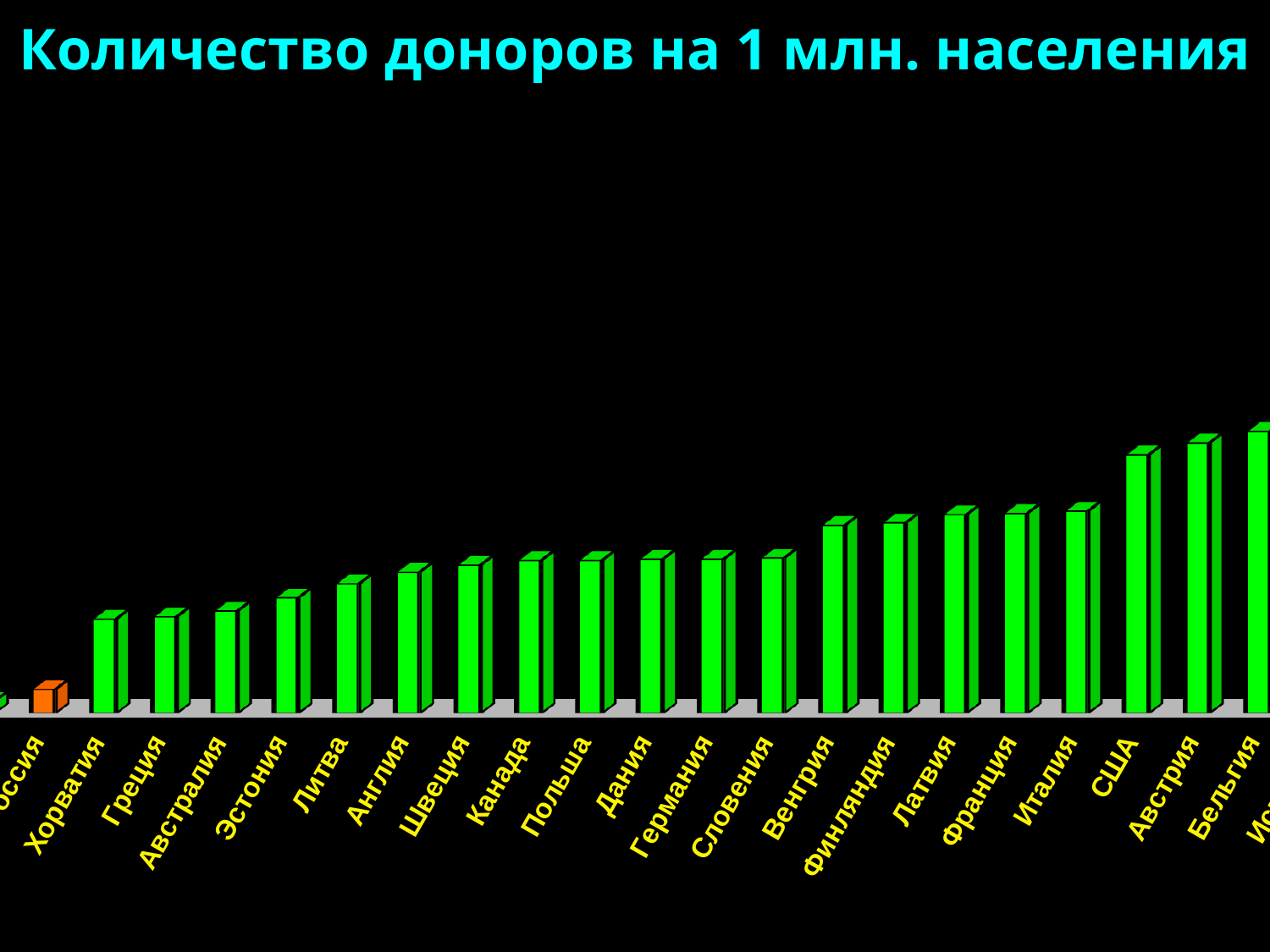
Which has the larger value, Италия or США? США Which has the larger value, Хорватия or Греция? Греция What is the title of the chart? Количество доноров на 1 млн. населения Which has the larger value, Словения or Латвия? Латвия Which country's bar is coloured orange instead of green? Хорватия What kind of chart is shown on the slide? bar chart Do the bar values generally rise or fall from left to right along the x axis? rise